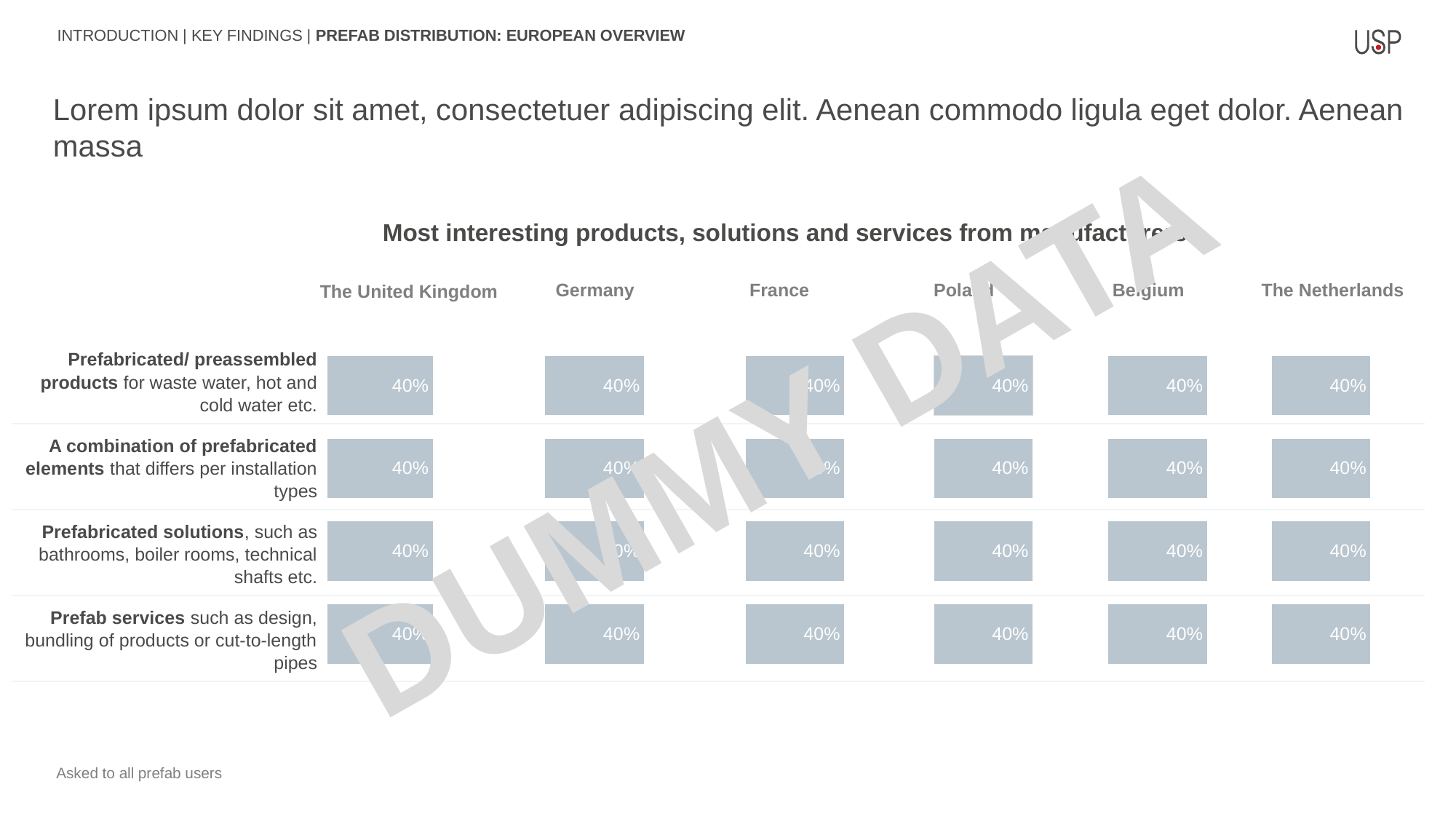
What is the title of the chart? Most interesting products, solutions and services from manufacturers What is the difference between The United Kingdom and The Netherlands for 'Prefabricated/ preassembled products for waste water, hot and cold water etc.'? 0 percentage points What is the value for Germany for 'Prefab services such as design, bundling of products or cut-to-length pipes'? 40% Do the values for 'Prefab services such as design, bundling of products or cut-to-length pipes' rise, fall or stay the same across the countries from left to right? Stay the same What is the value for The United Kingdom for 'Prefabricated/ preassembled products for waste water, hot and cold water etc.'? 40% What kind of chart is used to show the values on this slide? Bar chart What is the value for Belgium for 'A combination of prefabricated elements that differs per installation types'? 40% What is the value for France for 'Prefab services such as design, bundling of products or cut-to-length pipes'? 40% How many product/service categories are listed as rows in the chart? 4 Which country is shown in the first (leftmost) column of the chart? The United Kingdom How many countries are shown as columns in the chart? 6 What is the value for The Netherlands for 'Prefabricated solutions, such as bathrooms, boiler rooms, technical shafts etc.'? 40%